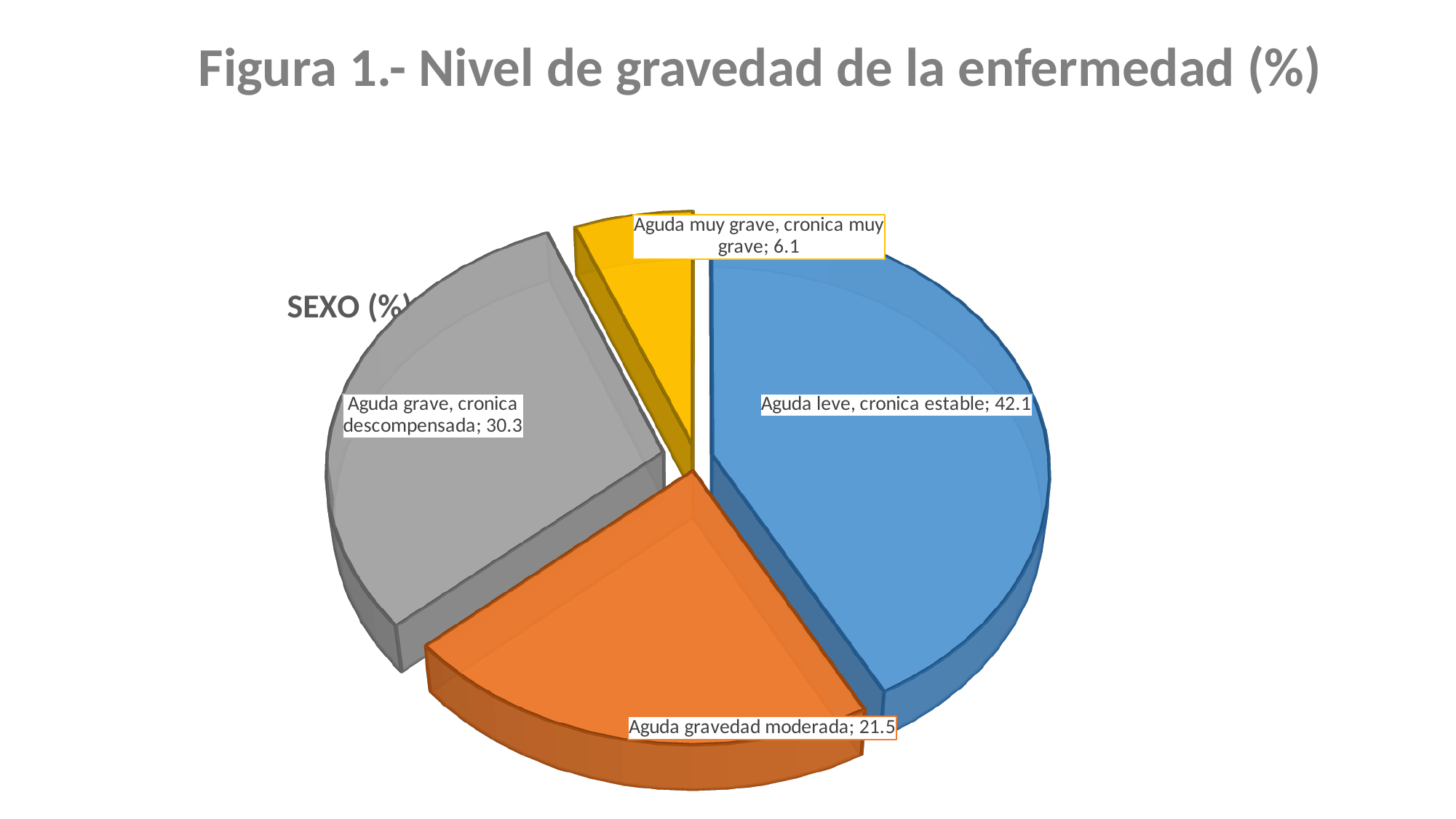
What kind of chart is shown on the slide? pie chart Which is larger, the value for "Aguda grave, cronica descompensada" or the value for "Aguda gravedad moderada"? Aguda grave, cronica descompensada Which category has the smallest slice of the pie? Aguda muy grave, cronica muy grave What is the value for "Aguda leve, cronica estable"? 42.1 What share of the pie does "Aguda gravedad moderada" represent? 21.5% What is the value for "Aguda muy grave, cronica muy grave"? 6.1 What is the value for "Aguda gravedad moderada"? 21.5 Which category has the largest slice of the pie? Aguda leve, cronica estable What is the difference between the values for "Aguda leve, cronica estable" and "Aguda grave, cronica descompensada"? 11.8 What is the value for "Aguda grave, cronica descompensada"? 30.3 What is the title of the figure on the slide? Figura 1.- Nivel de gravedad de la enfermedad (%) How many slices does the pie chart have? 4